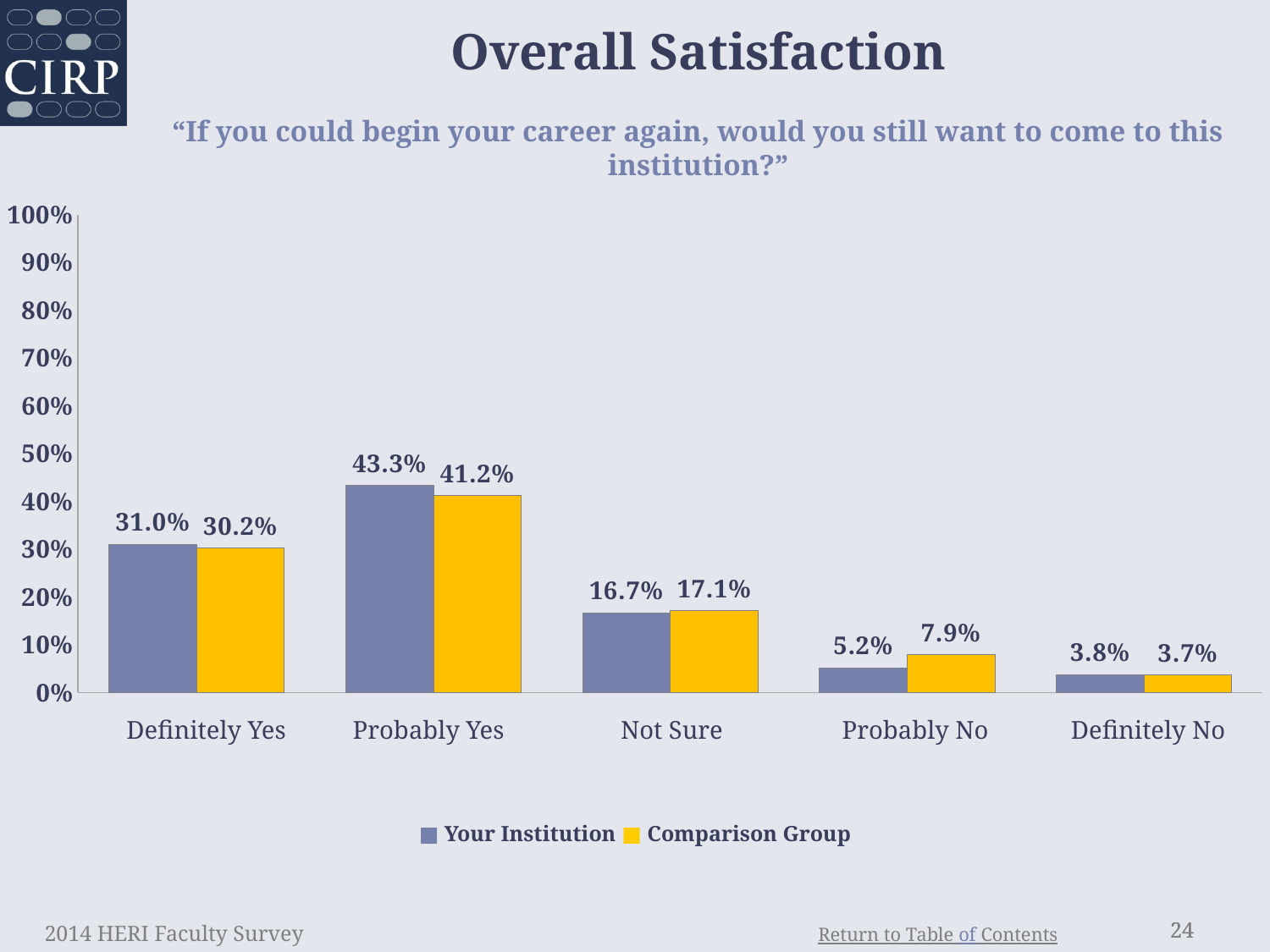
What is the value for Your Institution in the Probably Yes category? 43.3% What is the value for Your Institution in the Definitely No category? 3.8% What is the difference between Your Institution and Comparison Group in the Probably No category? 2.7% Which is larger in the Probably No category, Your Institution or Comparison Group? Comparison Group What is the value for Comparison Group in the Not Sure category? 17.1% How many response categories are shown on the x axis? 5 Which category has the lowest value for Comparison Group? Definitely No Which category has the highest value for Your Institution? Probably Yes What kind of chart is shown on the slide? Bar chart How many series does the legend list? 2 What is the difference between Your Institution and Comparison Group in the Probably Yes category? 2.1% Which colour represents the Comparison Group series? Yellow